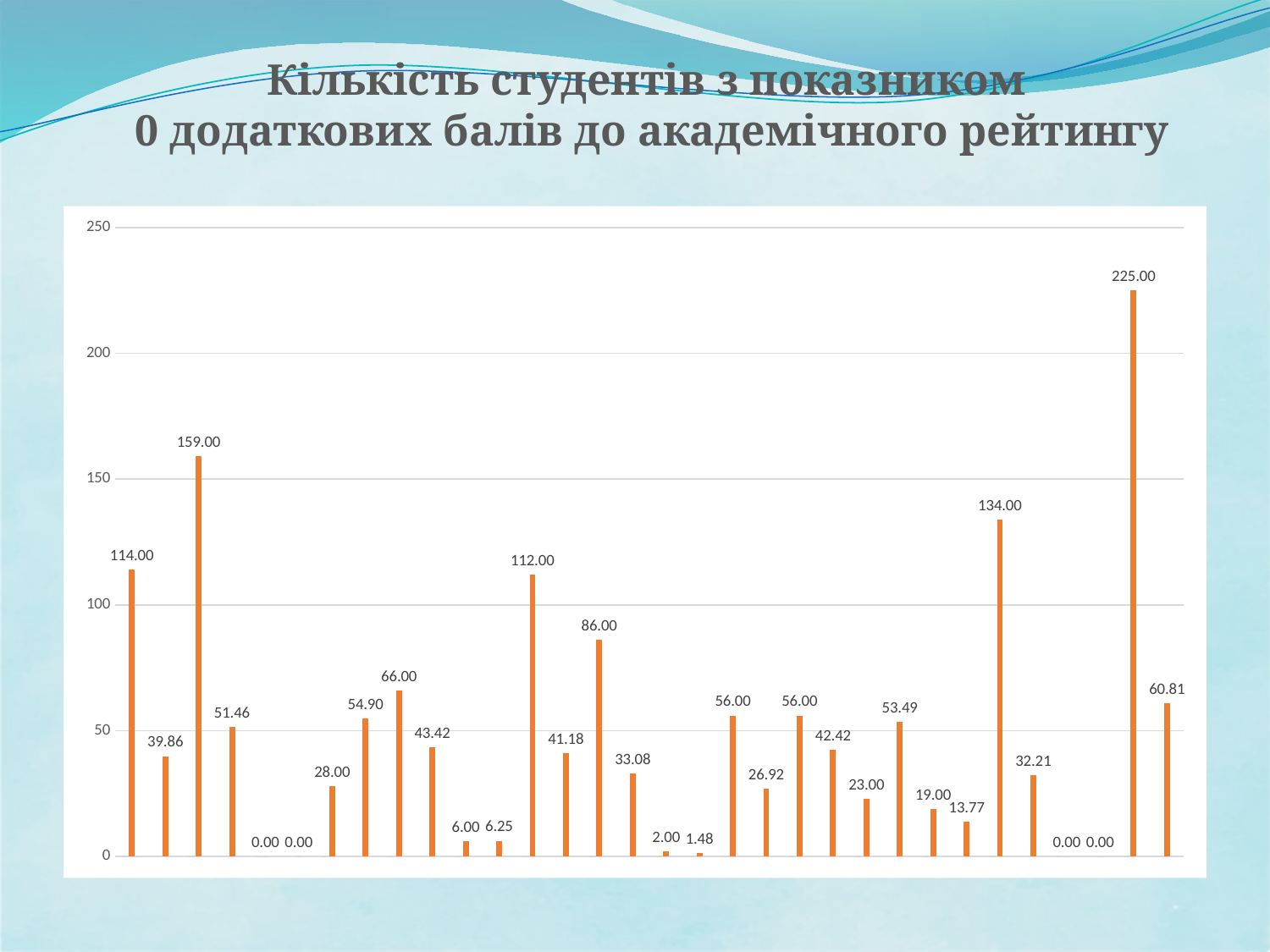
How many bars have a value of 0.00? 4 Is the tallest bar greater or less than 200? greater What is the lowest value shown in the chart? 0.00 What is the value of the last (rightmost) bar in the chart? 60.81 What kind of chart is shown on the slide? bar chart Which is larger, the first bar (114.00) or the last bar (60.81)? the first bar (114.00) What is the highest value shown in the chart? 225.00 What is the title of the chart on the slide? Кількість студентів з показником 0 додаткових балів до академічного рейтингу What is the difference between the highest value (225.00) and the second highest value (159.00)? 66.00 What is the value of the first (leftmost) bar in the chart? 114.00 What is the value of the third bar from the left? 159.00 How many bars (data points) are plotted in the chart? 32